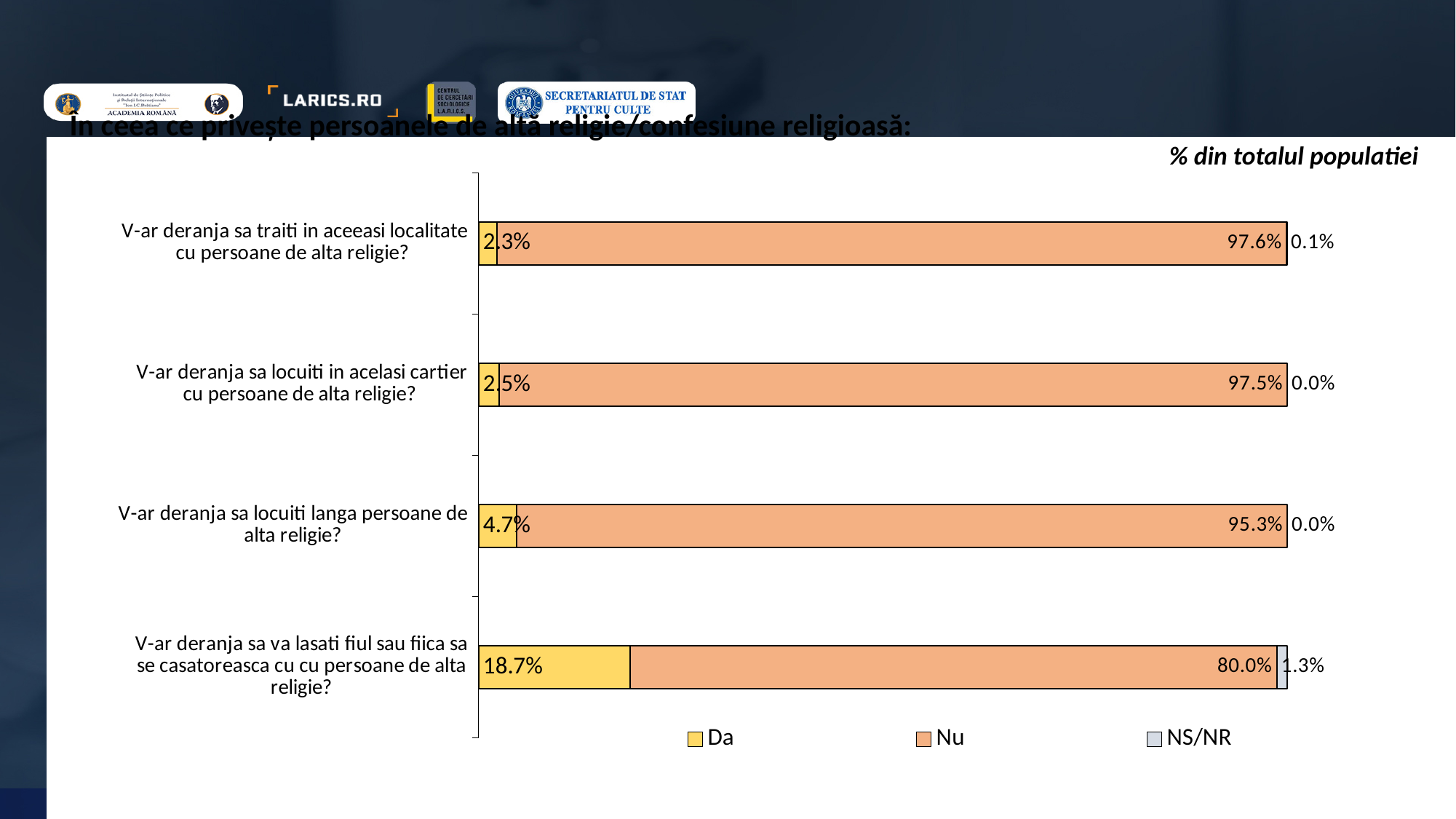
What is the "Da" value for "V-ar deranja sa locuiti langa persoane de alta religie?"? 4.7% What is the "NS/NR" value for "V-ar deranja sa va lasati fiul sau fiica sa se casatoreasca cu cu persoane de alta religie?"? 1.3% Which legend entry is shown in orange? Nu Which question has the lowest "Nu" value? V-ar deranja sa va lasati fiul sau fiica sa se casatoreasca cu cu persoane de alta religie? How many questions (categories) are shown in the chart? 4 What is the "Nu" value for "V-ar deranja sa traiti in aceeasi localitate cu persoane de alta religie?"? 97.6% What is the difference between the "Nu" values for "V-ar deranja sa traiti in aceeasi localitate cu persoane de alta religie?" and "V-ar deranja sa va lasati fiul sau fiica sa se casatoreasca cu cu persoane de alta religie?"? 17.6% Which is larger: the "Da" value for "V-ar deranja sa locuiti in acelasi cartier cu persoane de alta religie?" or the "Da" value for "V-ar deranja sa locuiti langa persoane de alta religie?"? V-ar deranja sa locuiti langa persoane de alta religie? Which question has the highest "Da" value? V-ar deranja sa va lasati fiul sau fiica sa se casatoreasca cu cu persoane de alta religie? What is the "Da" value for "V-ar deranja sa va lasati fiul sau fiica sa se casatoreasca cu cu persoane de alta religie?"? 18.7% How many series does the legend list? 3 What kind of chart is shown on the slide? Stacked bar chart